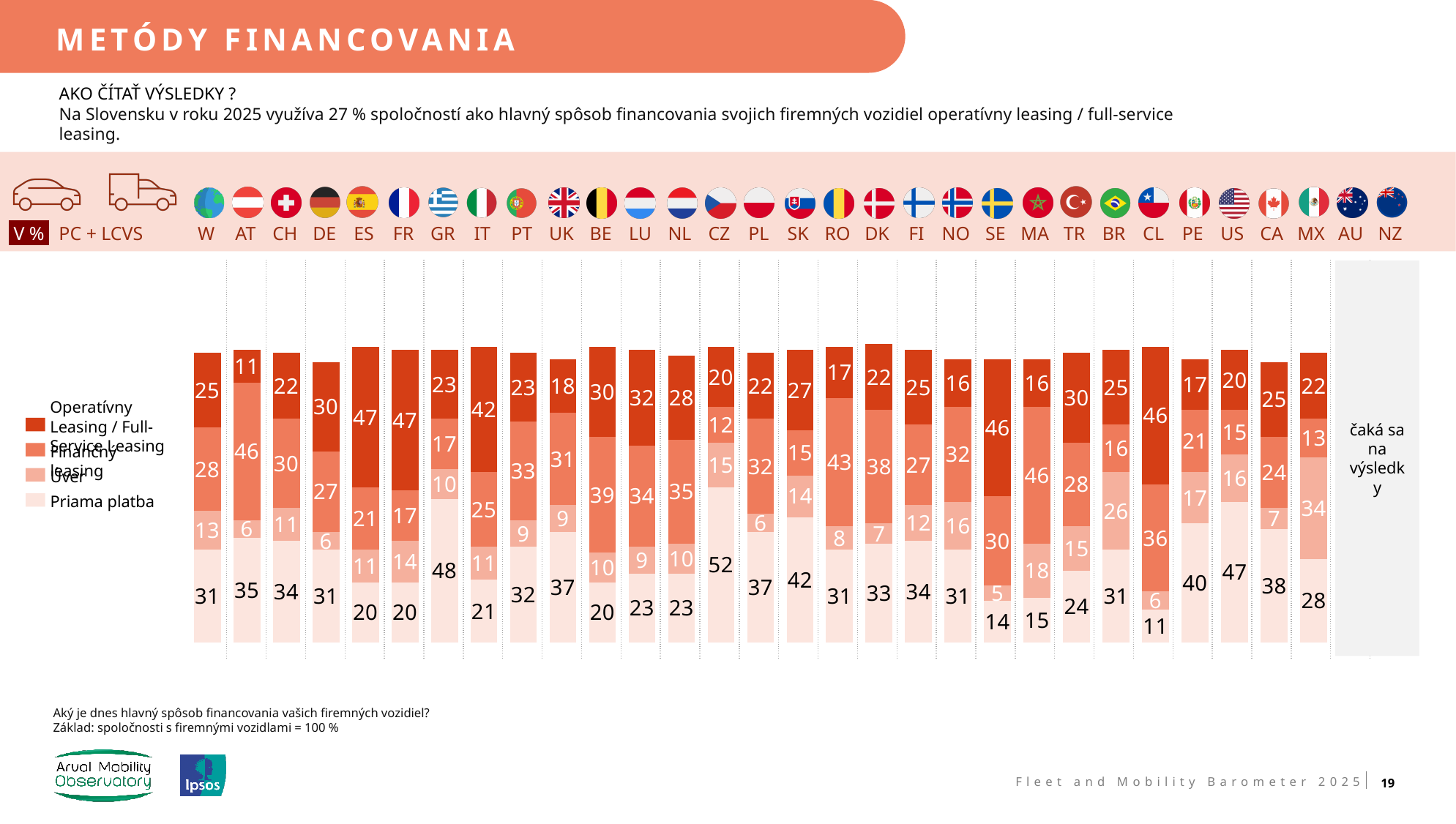
How many series does the legend list? 4 Which legend entry is shown in the darkest orange colour? Operatívny Leasing / Full-Service Leasing What is the value for Operatívny Leasing / Full-Service Leasing for SK? 27 How many countries are marked as awaiting results (čaká sa na výsledky)? 2 What is the value for Finančný leasing for RO? 43 What is the value for Priama platba for CZ? 52 Which country has the highest value for Priama platba? CZ Which country has the lowest value for Priama platba? CL Which has the larger Finančný leasing value, BE or NL? BE What kind of chart is shown on the slide? Stacked bar chart What is the total of the stacked bar for W? 97 What is the difference between the Operatívny Leasing / Full-Service Leasing values for ES and W? 22